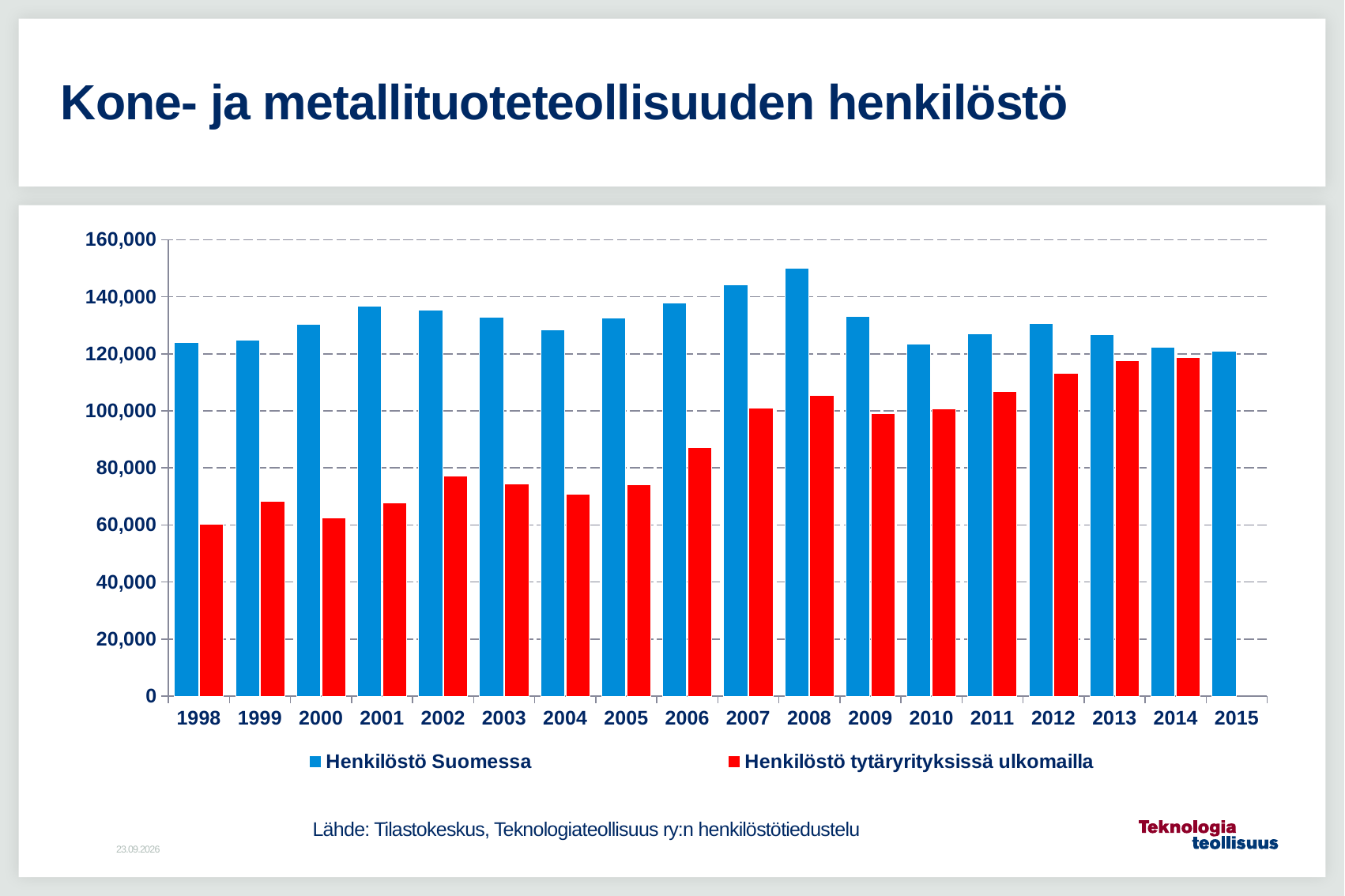
Is the value for Henkilöstö Suomessa in 2008 greater or less than 140,000? greater Is the value for Henkilöstö tytäryrityksissä ulkomailla in 2006 greater or less than 80,000? greater How many series does the legend list? 2 What kind of chart is shown on the slide? bar chart What is the title of the chart on the slide? Kone- ja metallituoteteollisuuden henkilöstö Is the value for Henkilöstö Suomessa in 2001 greater or less than 140,000? less In which year is the value for Henkilöstö Suomessa highest? 2008 How many years are shown on the x axis? 18 In 2008, which series has the larger value: Henkilöstö Suomessa or Henkilöstö tytäryrityksissä ulkomailla? Henkilöstö Suomessa Does the value for Henkilöstö tytäryrityksissä ulkomailla generally rise or fall from 1998 to 2014? rise